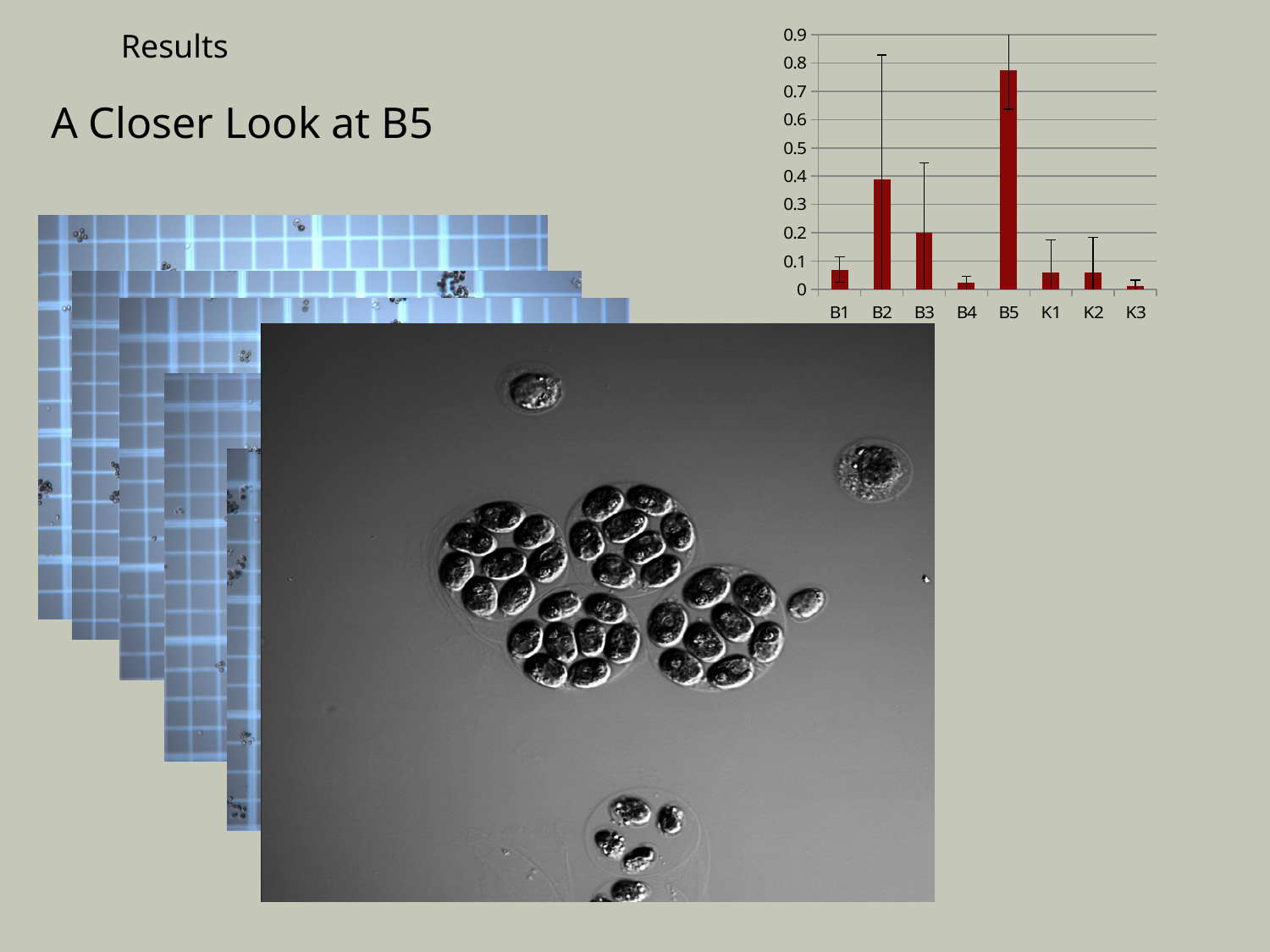
Which is larger, the value for B5 or the value for B2? B5 What colour are the bars in the chart? dark red What kind of chart is shown on the slide? bar chart Is the value for B5 greater or less than 0.7? greater Which is larger, the value for B2 or the value for B3? B2 Which is larger, the value for B1 or the value for B4? B1 Is the value for B1 greater or less than 0.2? less Is the value for B3 greater or less than 0.3? less How many categories are shown on the x axis of the chart? 8 What is the highest value shown on the y axis of the chart? 0.9 Which category has the highest bar in the chart? B5